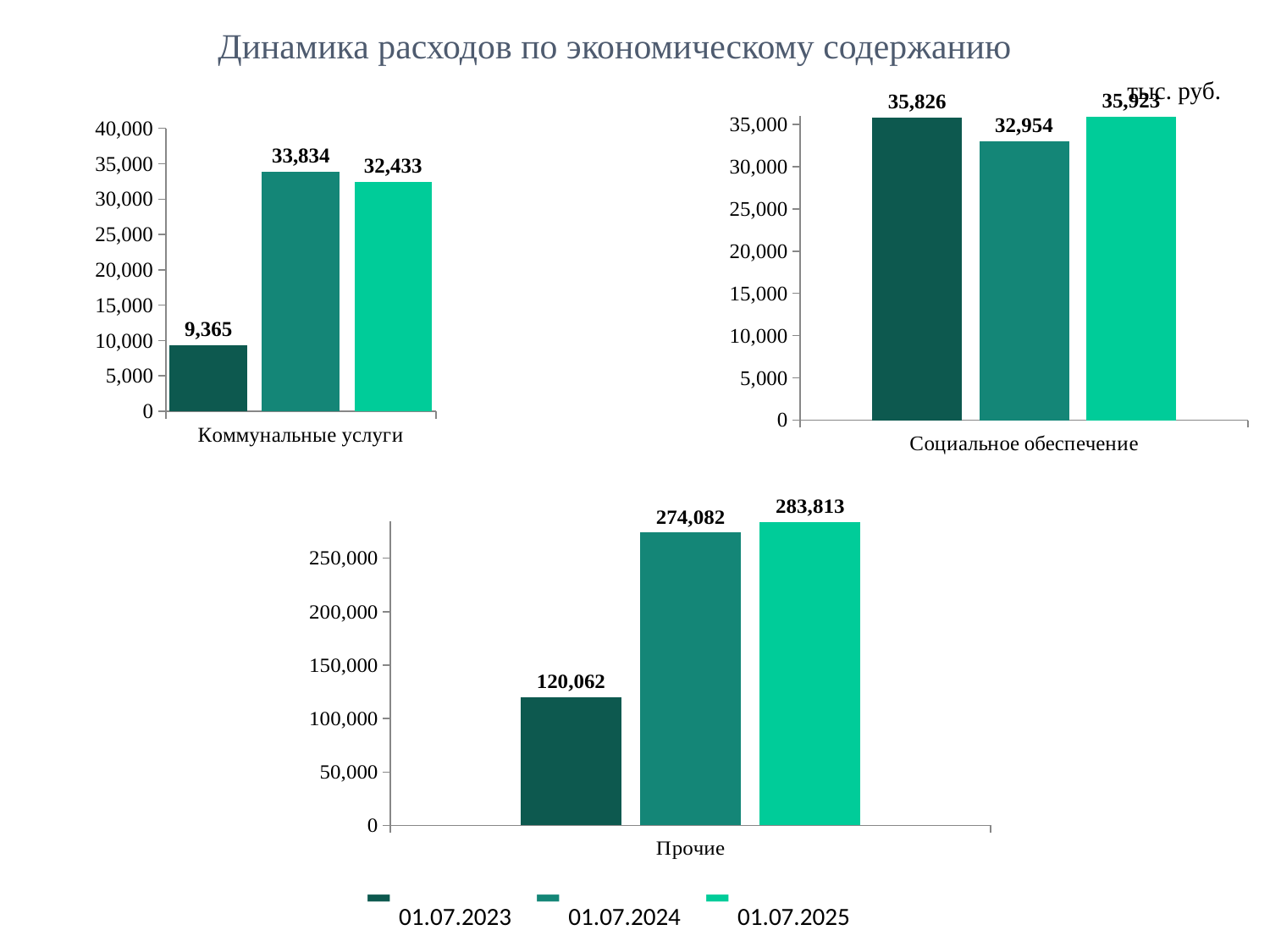
How many series does the legend at the bottom of the slide list? 3 In the Коммунальные услуги chart, what is the value for 01.07.2024? 33,834 In the Социальное обеспечение chart, what is the value for 01.07.2023? 35,826 In the Прочие chart, which date has the highest value? 01.07.2025 In the Коммунальные услуги chart, what is the difference between the 01.07.2024 and 01.07.2025 values? 1,401 In the Прочие chart, is the value for 01.07.2023 greater or less than 150,000? less In the Социальное обеспечение chart, what is the value for 01.07.2024? 32,954 In the Социальное обеспечение chart, which date has the lowest value? 01.07.2024 In the Прочие chart, what is the value for 01.07.2025? 283,813 In the Коммунальные услуги chart, which date has the lowest value? 01.07.2023 In the Коммунальные услуги chart, what is the value for 01.07.2023? 9,365 In the Прочие chart, what is the difference between the 01.07.2024 and 01.07.2023 values? 154,020